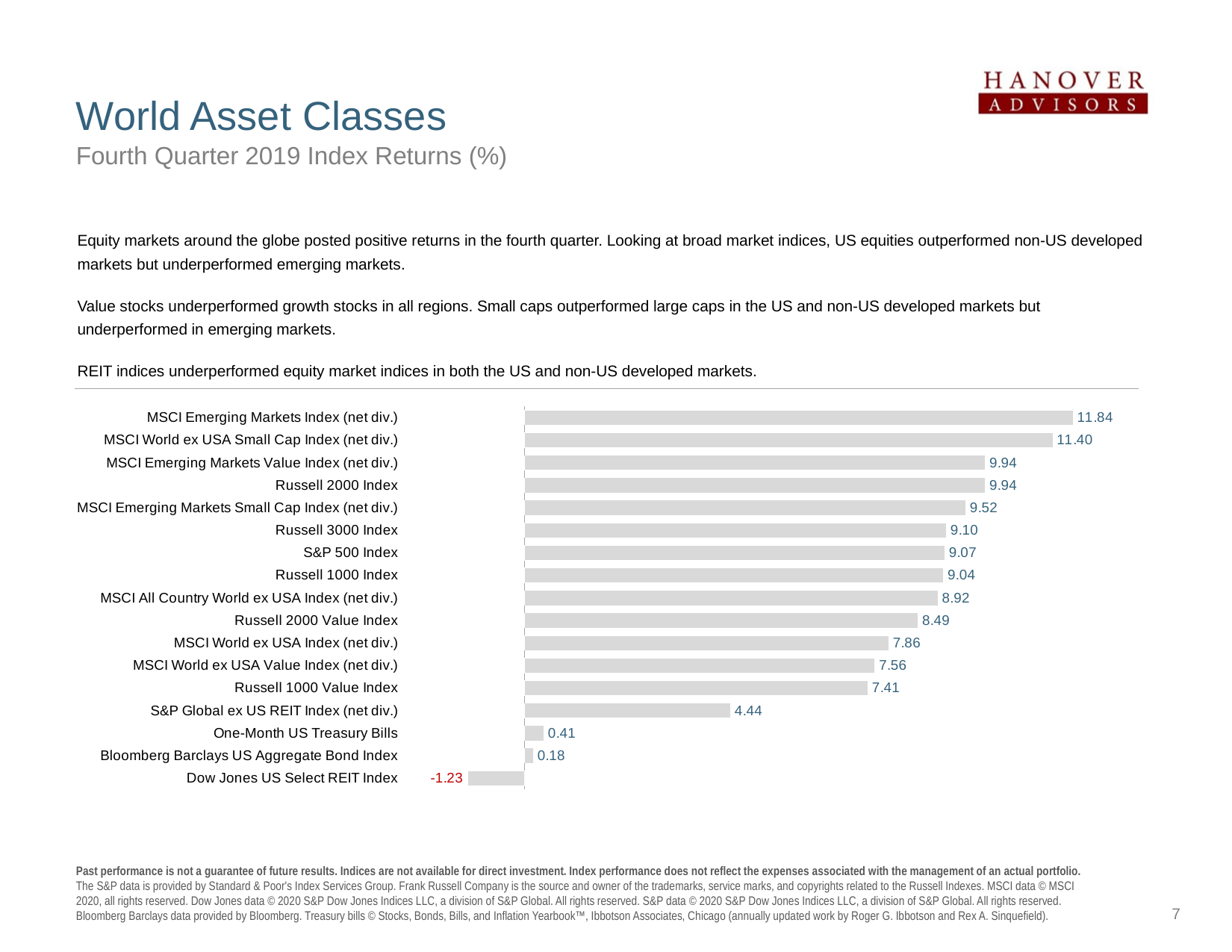
How many indices are plotted on the chart? 17 What is the value shown for One-Month US Treasury Bills? 0.41 What is the difference between the returns of the Russell 2000 Index and the Russell 2000 Value Index? 1.45 What is the value shown for the S&P 500 Index? 9.07 What is the value shown for the Dow Jones US Select REIT Index? -1.23 Which index has the highest return on the chart? MSCI Emerging Markets Index (net div.) Which has the larger return, the MSCI World ex USA Index (net div.) or the MSCI World ex USA Value Index (net div.)? MSCI World ex USA Index (net div.) Which index has the lowest return on the chart? Dow Jones US Select REIT Index What is the subtitle of the chart on the slide? Fourth Quarter 2019 Index Returns (%) What is the difference between the returns of the S&P Global ex US REIT Index (net div.) and the Dow Jones US Select REIT Index? 5.67 What kind of chart is shown on the slide? Bar chart What is the fourth quarter 2019 return for the MSCI Emerging Markets Index (net div.)? 11.84